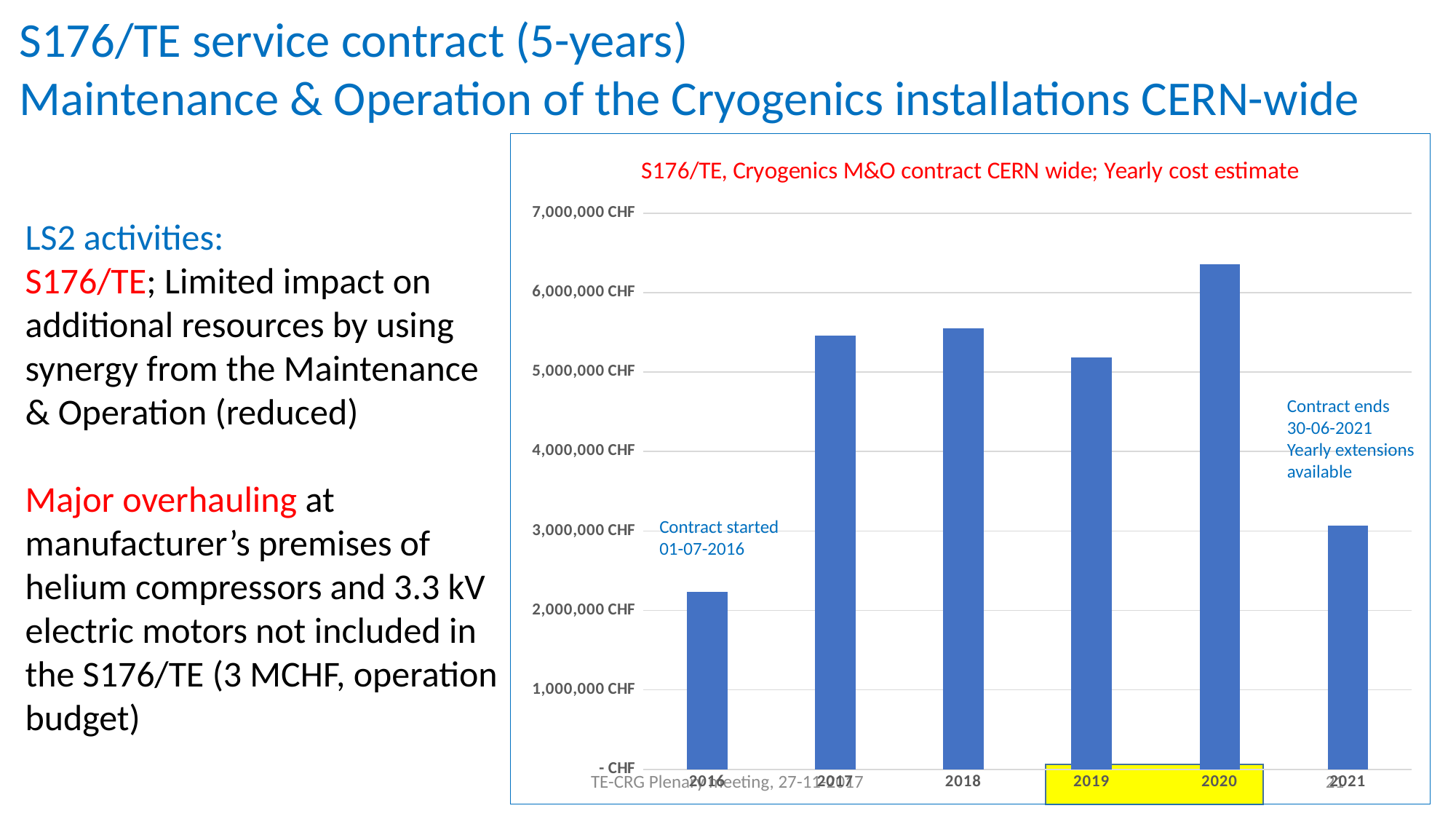
Is the value for 2021 greater or less than 4,000,000 CHF? less Is the value for 2017 greater or less than 5,000,000 CHF? greater Which year has the highest yearly cost estimate? 2020 Which year has the larger cost estimate, 2016 or 2021? 2021 Which year has the lowest yearly cost estimate? 2016 What kind of chart is shown on the slide? bar chart Which year has the larger cost estimate, 2019 or 2020? 2020 Is the value for 2016 greater or less than 2,000,000 CHF? greater How many years are shown on the x axis of the chart? 6 What is the title of the chart? S176/TE, Cryogenics M&O contract CERN wide; Yearly cost estimate